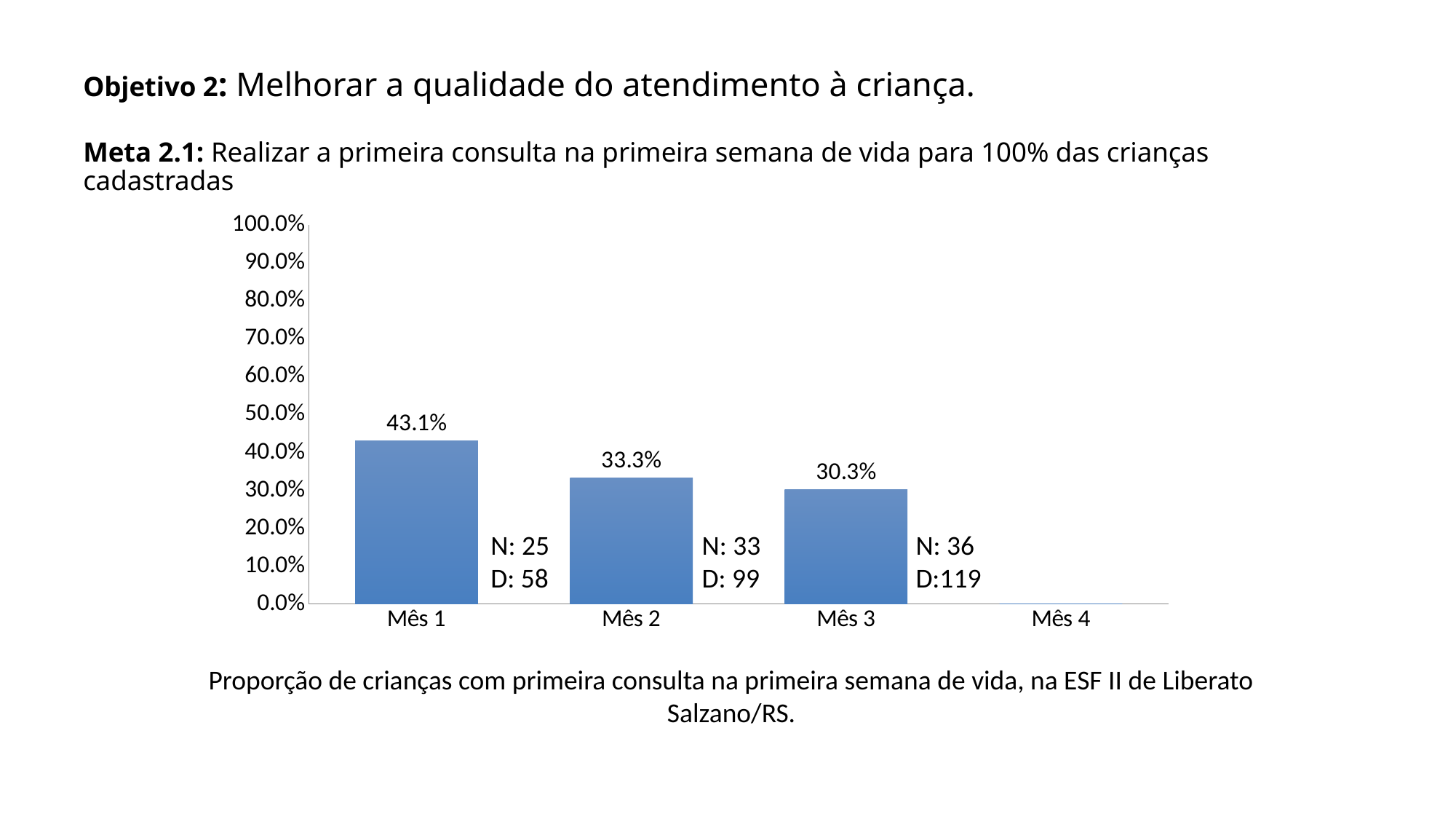
What is the value for Mês 1? 43.1% Which month has the highest value? Mês 1 What is the difference between the values for Mês 2 and Mês 3? 3.0% Is the value for Mês 1 greater or less than 50.0%? less Which is larger, the value for Mês 1 or the value for Mês 3? Mês 1 What kind of chart is shown on the slide? Bar chart What is the value for Mês 3? 30.3% How many month categories are shown on the x axis? 4 Among the months with a plotted bar, which has the lowest value? Mês 3 Do the values rise or fall from Mês 1 to Mês 3? Fall What is the value for Mês 2? 33.3% What is the difference between the values for Mês 1 and Mês 2? 9.8%